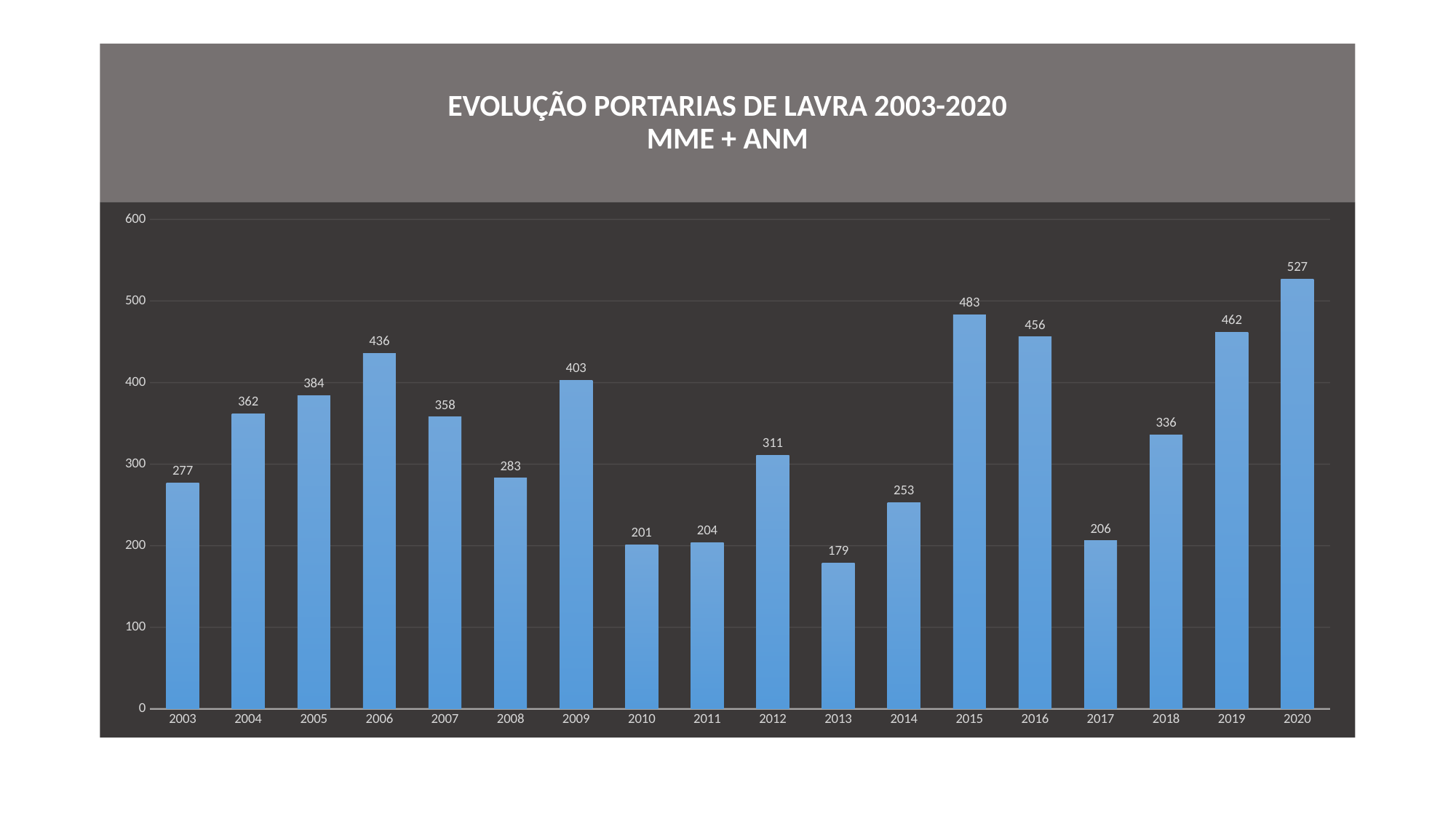
What is the difference between the values for 2015 and 2014? 230 Which year has the lowest value? 2013 Which year has the highest value? 2020 How many years are shown on the x axis? 18 Which is larger, the value for 2009 or the value for 2005? 2009 What is the difference between the values for 2020 and 2019? 65 What is the value for 2013? 179 What is the title of the chart? EVOLUÇÃO PORTARIAS DE LAVRA 2003-2020 MME + ANM What is the value for 2017? 206 What kind of chart is shown on the slide? Bar chart What is the value for 2006? 436 Is the value for 2012 greater or less than 300? greater